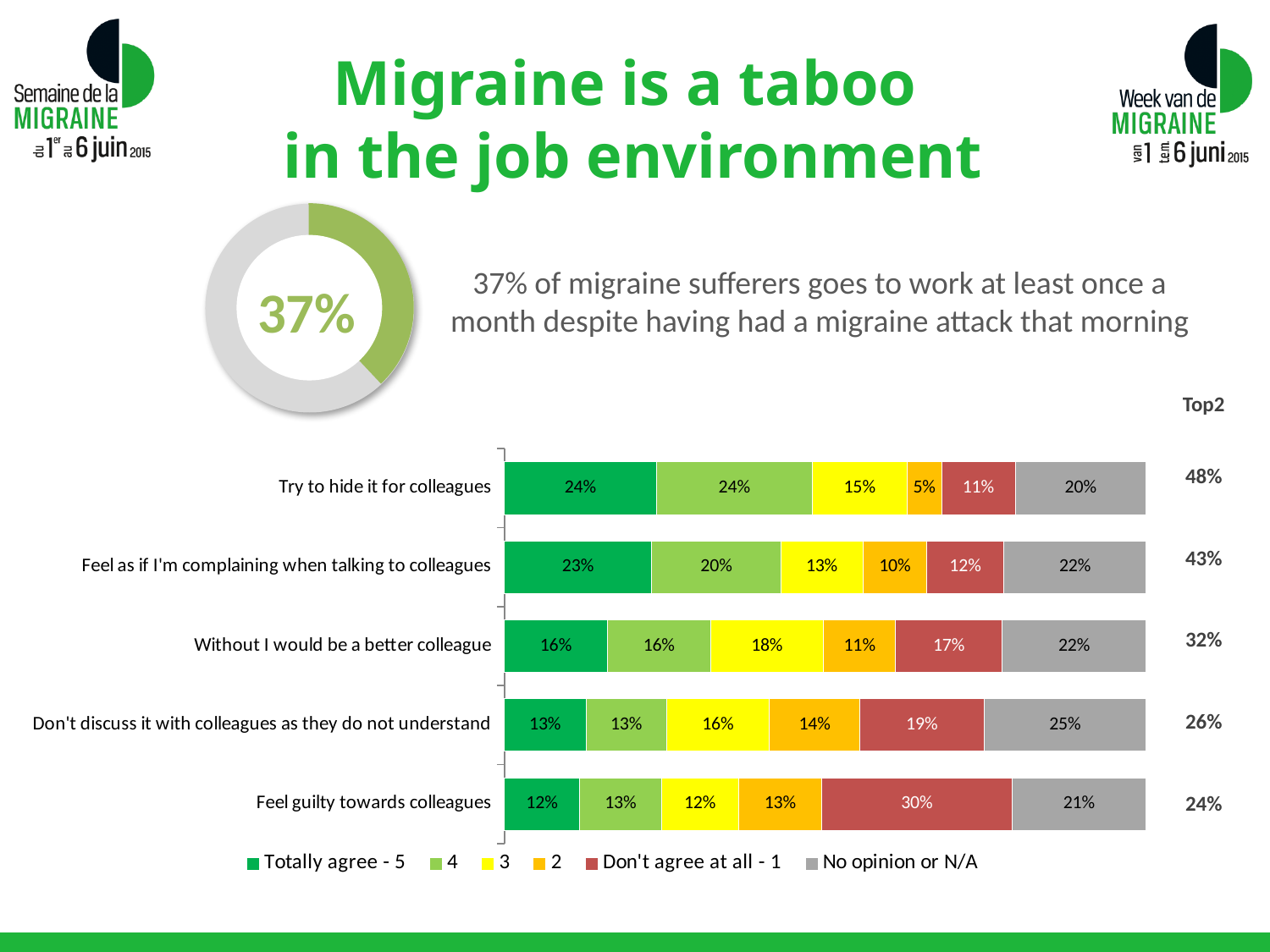
In the stacked bar chart, which statement has the lowest 'Totally agree - 5' value? Feel guilty towards colleagues In the stacked bar chart, what is the 'Don't agree at all - 1' value for 'Feel guilty towards colleagues'? 30% In the stacked bar chart, what is the difference between the 'Totally agree - 5' values for 'Try to hide it for colleagues' and 'Feel guilty towards colleagues'? 12 percentage points In the stacked bar chart, what is the '2' value for 'Try to hide it for colleagues'? 5% In the stacked bar chart, which statement has the highest 'Don't agree at all - 1' value? Feel guilty towards colleagues How many series does the legend of the stacked bar chart list? 6 In the stacked bar chart, which has the larger 'No opinion or N/A' value: 'Don't discuss it with colleagues as they do not understand' or 'Try to hide it for colleagues'? Don't discuss it with colleagues as they do not understand In the stacked bar chart, what is the Top2 value shown for 'Without I would be a better colleague'? 32% How many statements (categories) are shown in the stacked bar chart? 5 What value is shown in the centre of the donut chart at the top left of the slide? 37% In the stacked bar chart, what is the 'Totally agree - 5' value for 'Try to hide it for colleagues'? 24% What kind of chart is the chart at the bottom of the slide? Stacked bar chart